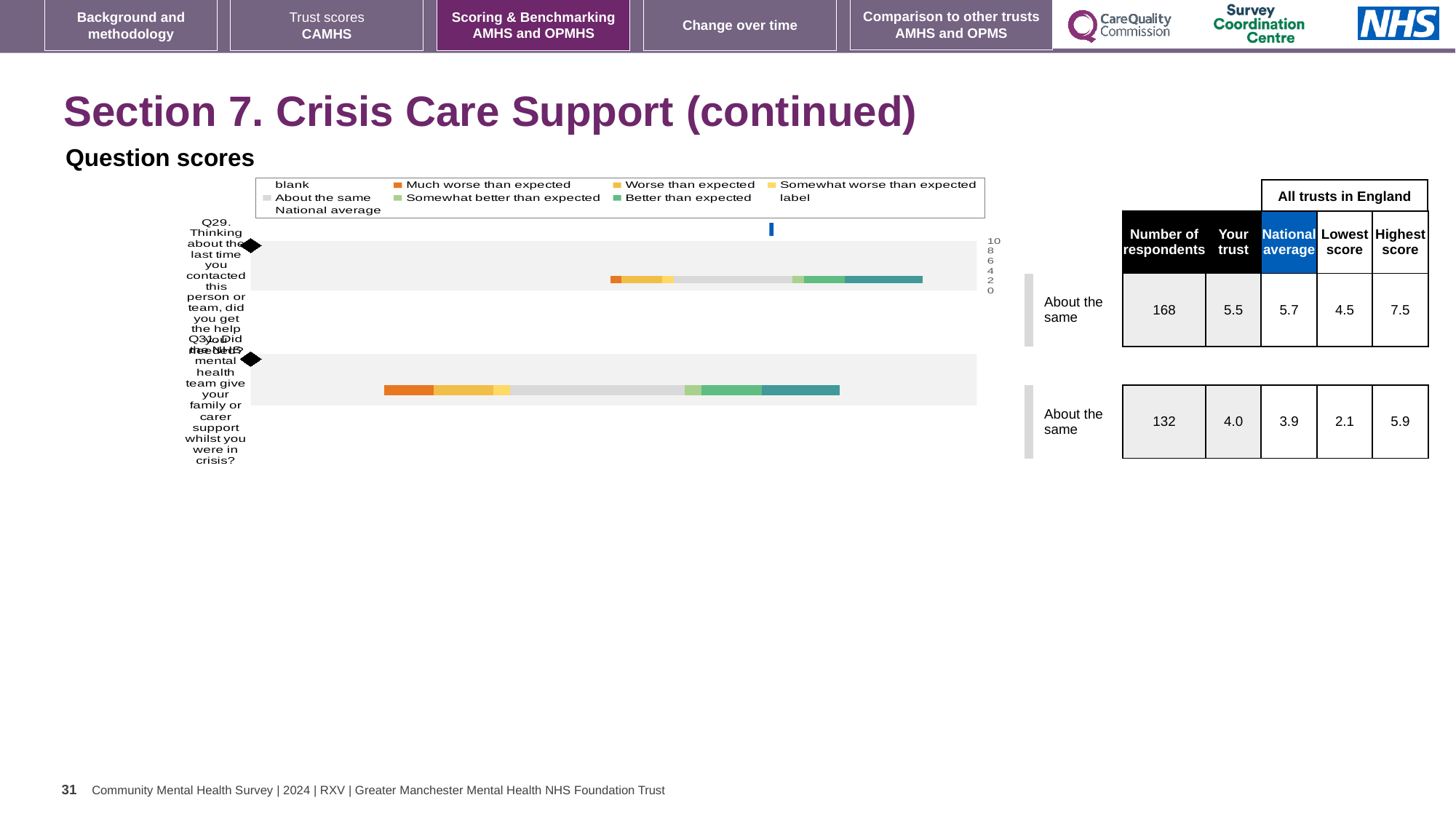
In the table beside the chart, which question has the higher 'Your trust' score, Q29 or Q31? Q29 In the table beside the chart, what is the national average for Q29? 5.7 Which legend entry is shown in light grey? About the same In the table beside the chart, what is 'Your trust' score for Q31? 4.0 Which legend entry is shown in orange? Much worse than expected How many entries does the chart legend list? 9 In the table beside the chart, what is the benchmark category shown for Q31? About the same In the table beside the chart, what is the number of respondents for Q29? 168 In the table beside the chart, what is the difference between the highest and lowest score for Q29? 3.0 What kind of chart is shown under 'Question scores'? bar chart In the table beside the chart, what is the highest score for Q31? 5.9 How many questions (bars) are plotted in the chart? 2